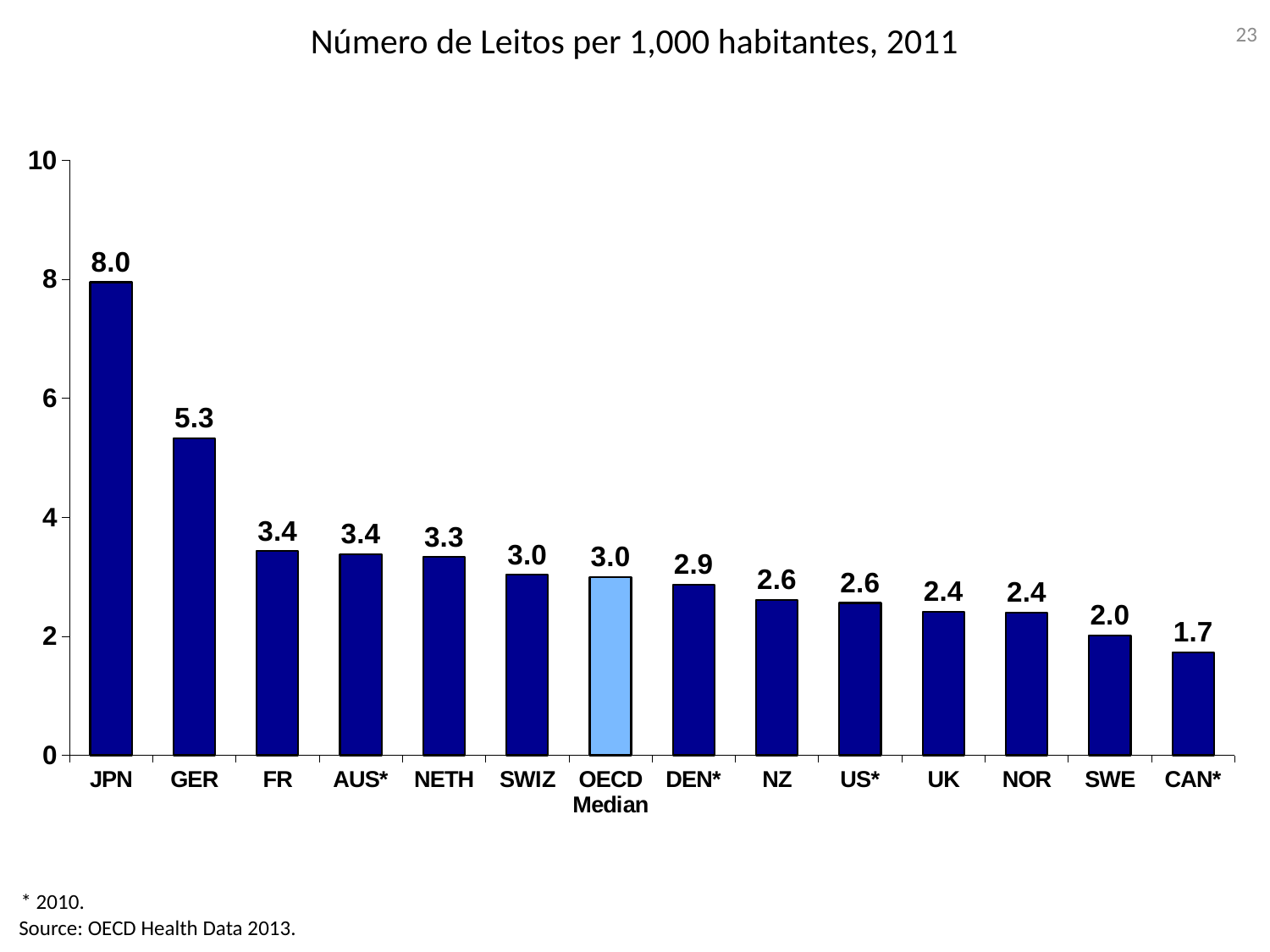
What is the value for CAN*? 1.7 Is the value for SWE greater or less than 4? less Do the values rise or fall from left to right along the x axis? fall What kind of chart is shown? bar chart What is the difference between the values for JPN and GER? 2.7 How many categories are shown on the x axis? 14 What is the title of the chart? Número de Leitos per 1,000 habitantes, 2011 Which is larger, the value for GER or the value for FR? GER Which category has the lowest value? CAN* Which category has the highest value? JPN What is the value for JPN? 8.0 What is the value for the OECD Median? 3.0